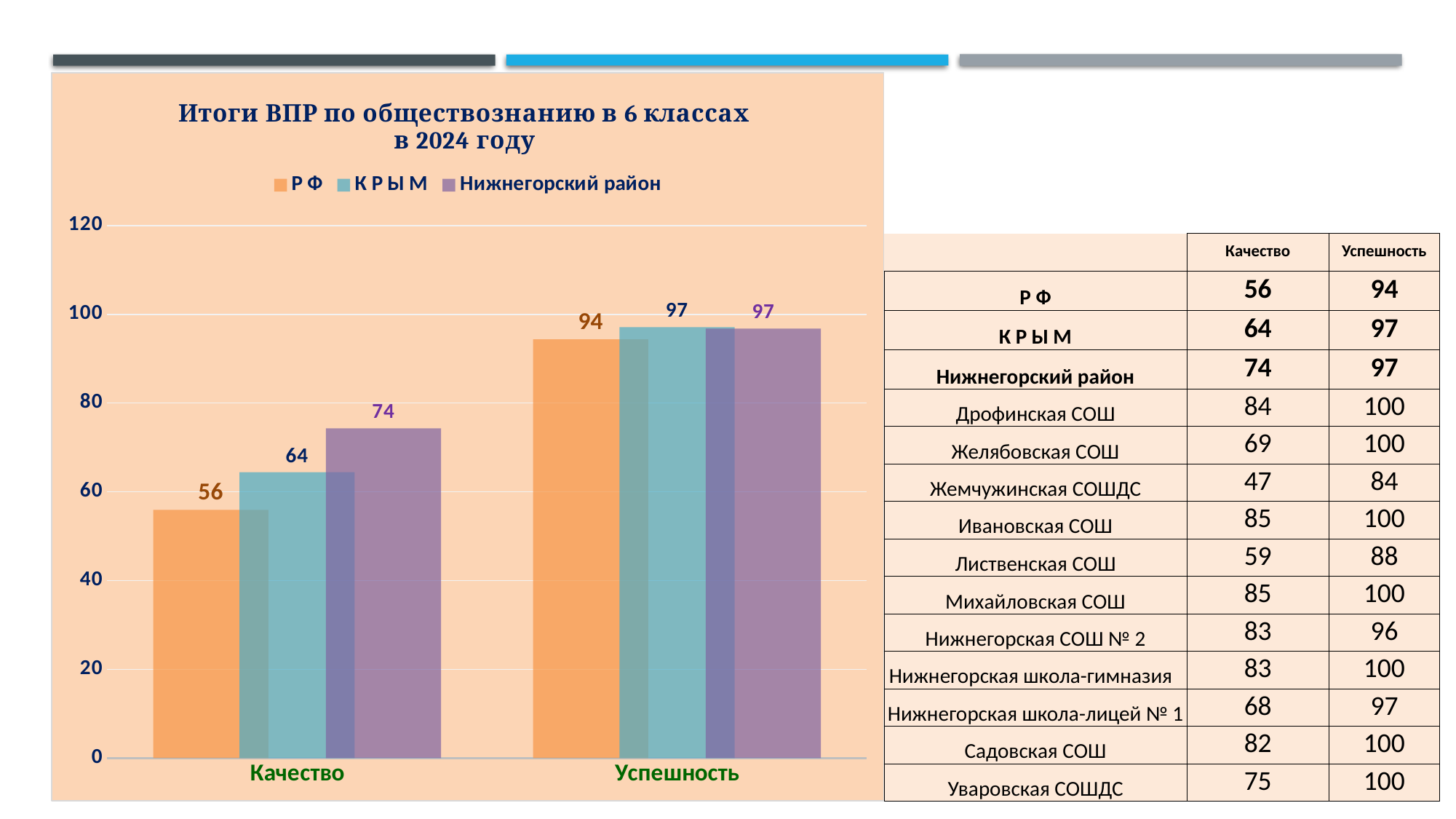
How many categories are shown on the x axis? 2 What kind of chart is shown on the slide? bar chart What is the value for Р Ф in the Качество category? 56 How many series does the legend list? 3 What is the value for Нижнегорский район in the Качество category? 74 Which is larger: the К Р Ы М value for Качество or the К Р Ы М value for Успешность? Успешность What is the value for К Р Ы М in the Успешность category? 97 What is the value for Р Ф in the Успешность category? 94 Which series has the highest value in the Качество category? Нижнегорский район Which series has the lowest value in the Успешность category? Р Ф What is the difference between the Нижнегорский район and Р Ф values in the Качество category? 18 Is the value for Р Ф in the Качество category greater or less than 60? less